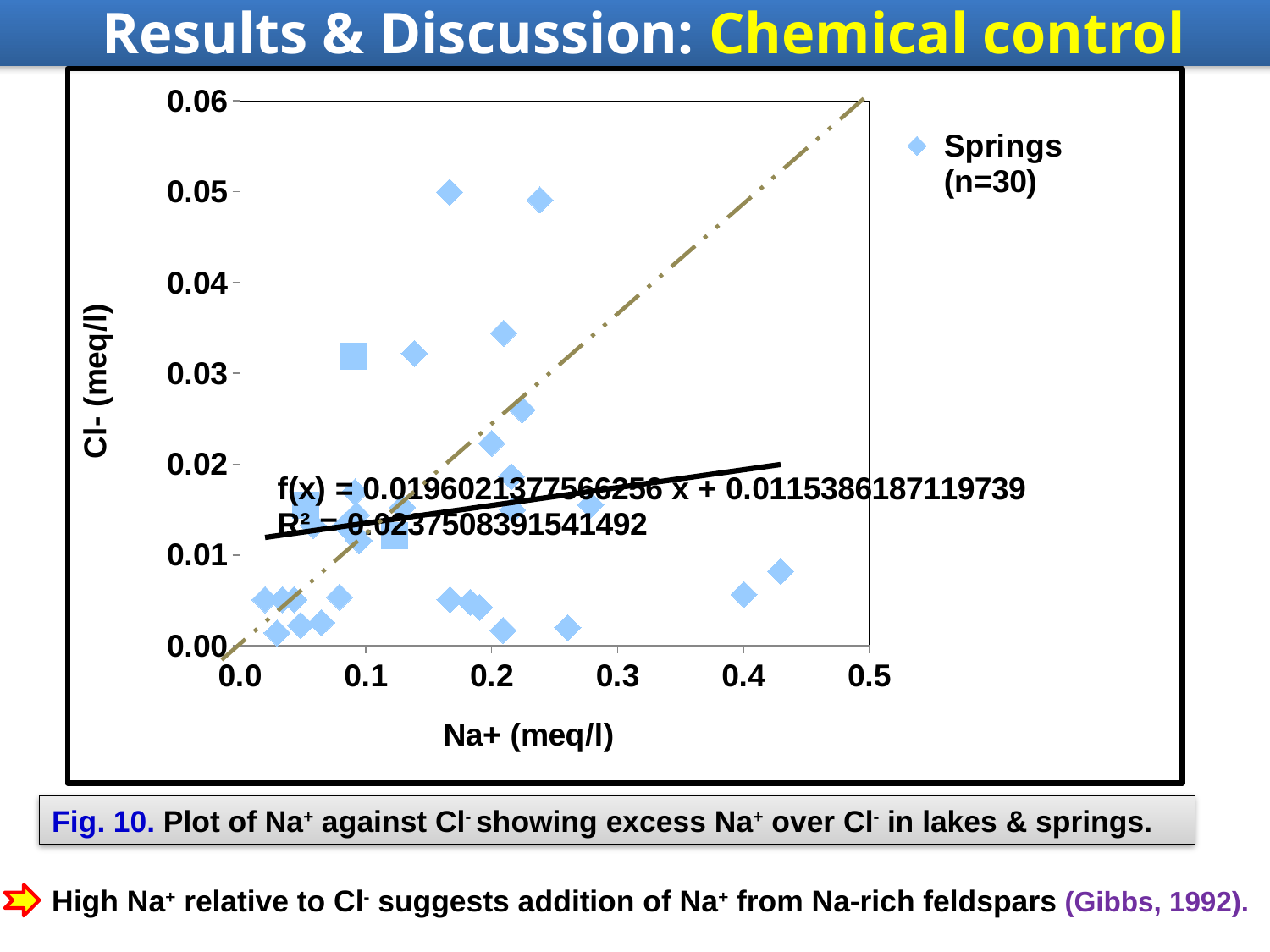
What is the slope of the fitted line f(x) printed on the chart? 0.0196021377566256 How many series does the legend list? 1 What kind of chart is shown on the slide? Scatter plot What is the intercept of the fitted line f(x) printed on the chart? 0.0115386187119739 Does the fitted trendline slope upward or downward as Na+ increases? upward What is the maximum value shown on the y axis? 0.06 According to the legend, how many data points (n) are in the Springs series? 30 Is the highest Cl- value among the plotted points greater or less than 0.04 meq/l? greater Is the Cl- value of the point with the largest Na+ (around 0.43 meq/l) greater or less than 0.01 meq/l? less What is the R² value printed for the fitted trendline? 0.0237508391541492 What is the label of the x axis? Na+ (meq/l) What is the name of the series shown in the legend? Springs (n=30)